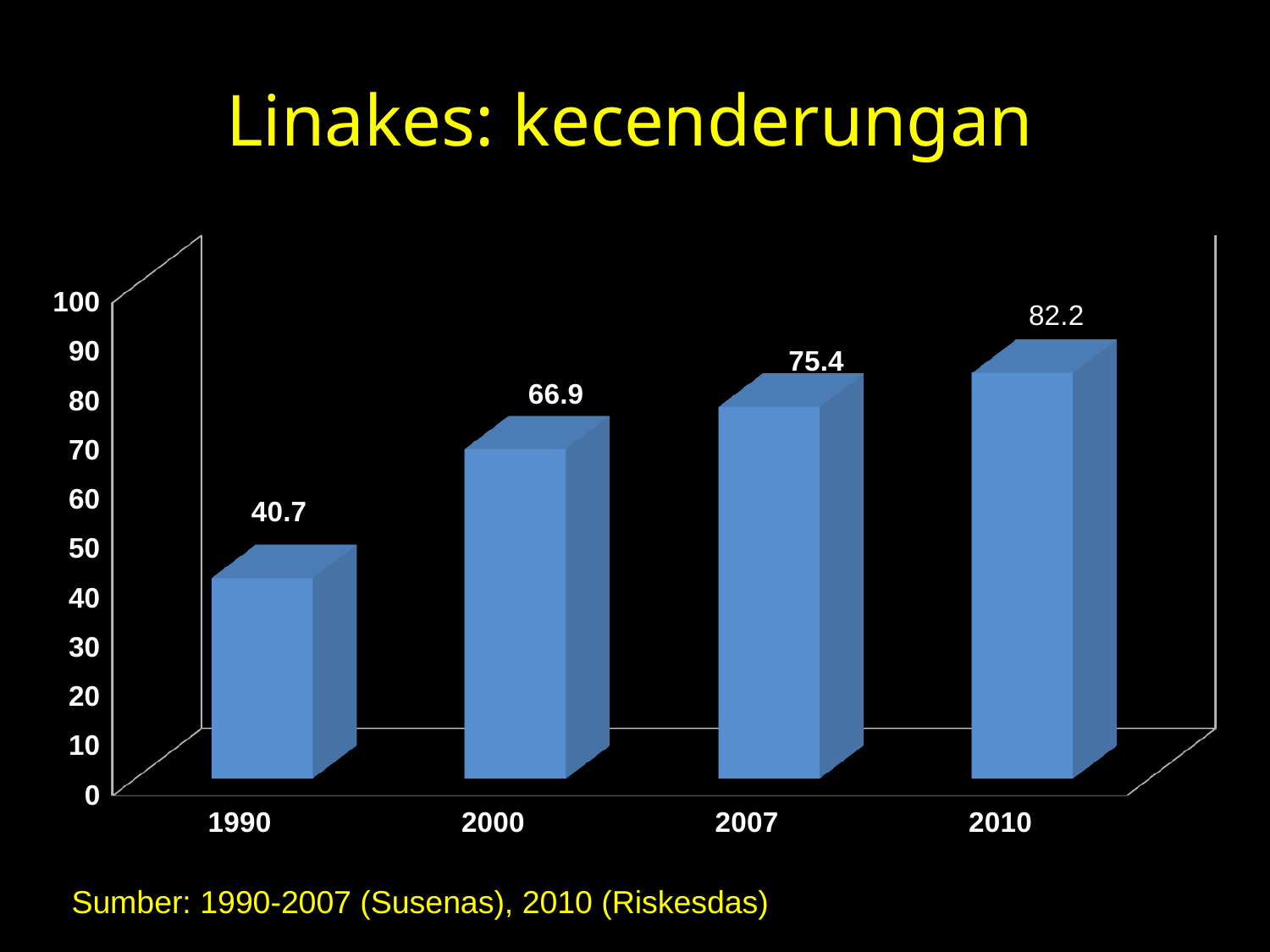
What is the value for 1990? 40.7 What is the value for 2010? 82.2 Which year has the highest value? 2010 What is the difference between the values for 2010 and 1990? 41.5 How many years are shown on the x axis? 4 Do the values rise or fall from 1990 to 2010? rise What is the value for 2007? 75.4 What is the value for 2000? 66.9 Which is larger, the value for 2007 or the value for 2000? 2007 Which year has the lowest value? 1990 What is the difference between the values for 2000 and 1990? 26.2 What kind of chart is shown on the slide? bar chart